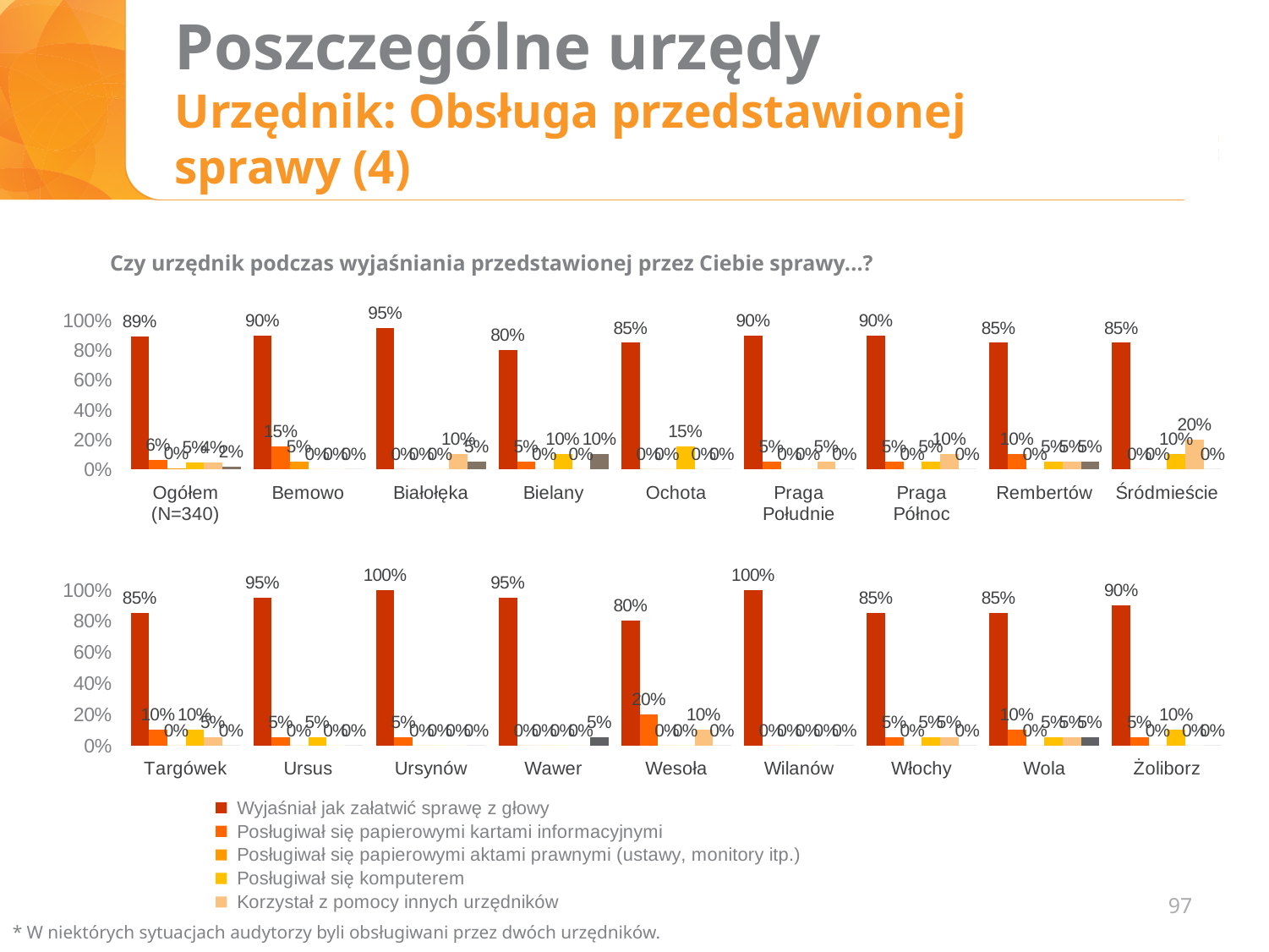
In the bottom chart, which is larger for 'Wyjaśniał jak załatwić sprawę z głowy': Ursus or Wesoła? Ursus How many series does the legend list? 5 In the top chart, which district has the highest value for 'Wyjaśniał jak załatwić sprawę z głowy'? Białołęka In the bottom chart, which district has the lowest value for 'Wyjaśniał jak załatwić sprawę z głowy'? Wesoła In the bottom chart, what is the value for 'Posługiwał się papierowymi kartami informacyjnymi' for Wesoła? 20% How many districts/categories are shown on the x axis of the bottom chart? 9 What kind of chart is used on this slide? Bar chart In the top chart, what is the value for 'Korzystał z pomocy innych urzędników' for Śródmieście? 20% In the bottom chart, what is the value for 'Wyjaśniał jak załatwić sprawę z głowy' for Żoliborz? 90% In the top chart, what is the value for 'Wyjaśniał jak załatwić sprawę z głowy' for Ogółem (N=340)? 89% In the top chart, which district has the lowest value for 'Wyjaśniał jak załatwić sprawę z głowy'? Bielany In the top chart, what is the difference between Białołęka and Bielany for 'Wyjaśniał jak załatwić sprawę z głowy'? 15 percentage points